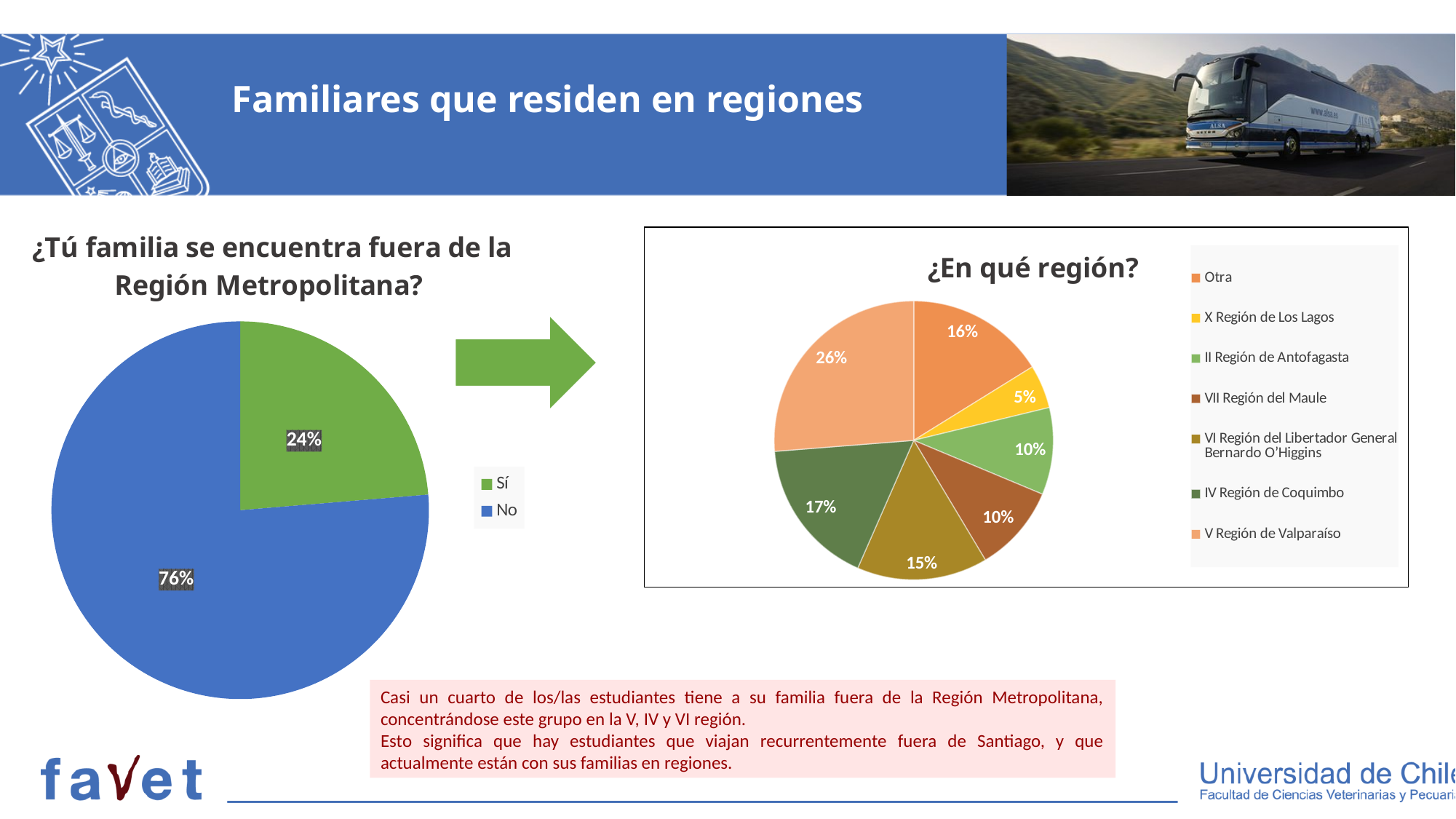
In the chart titled '¿Tú familia se encuentra fuera de la Región Metropolitana?', what percentage answered 'No'? 76% What kind of chart is the one titled '¿Tú familia se encuentra fuera de la Región Metropolitana?'? Pie chart In the chart titled '¿En qué región?', which is larger: the share for VI Región del Libertador General Bernardo O'Higgins or the share for Otra? Otra In the chart titled '¿En qué región?', which region has the smallest share? X Región de Los Lagos In the chart titled '¿En qué región?', how many categories does the legend list? 7 In the chart titled '¿En qué región?', what is the difference between the shares for V Región de Valparaíso and VII Región del Maule? 16% In the chart titled '¿En qué región?', what is the share for V Región de Valparaíso? 26% In the chart titled '¿En qué región?', which region has the largest share? V Región de Valparaíso In the chart titled '¿En qué región?', what is the share for X Región de Los Lagos? 5% In the chart titled '¿Tú familia se encuentra fuera de la Región Metropolitana?', what is the difference between the 'No' and 'Sí' shares? 52% In the chart titled '¿En qué región?', what is the share for IV Región de Coquimbo? 17% In the chart titled '¿Tú familia se encuentra fuera de la Región Metropolitana?', what percentage answered 'Sí'? 24%